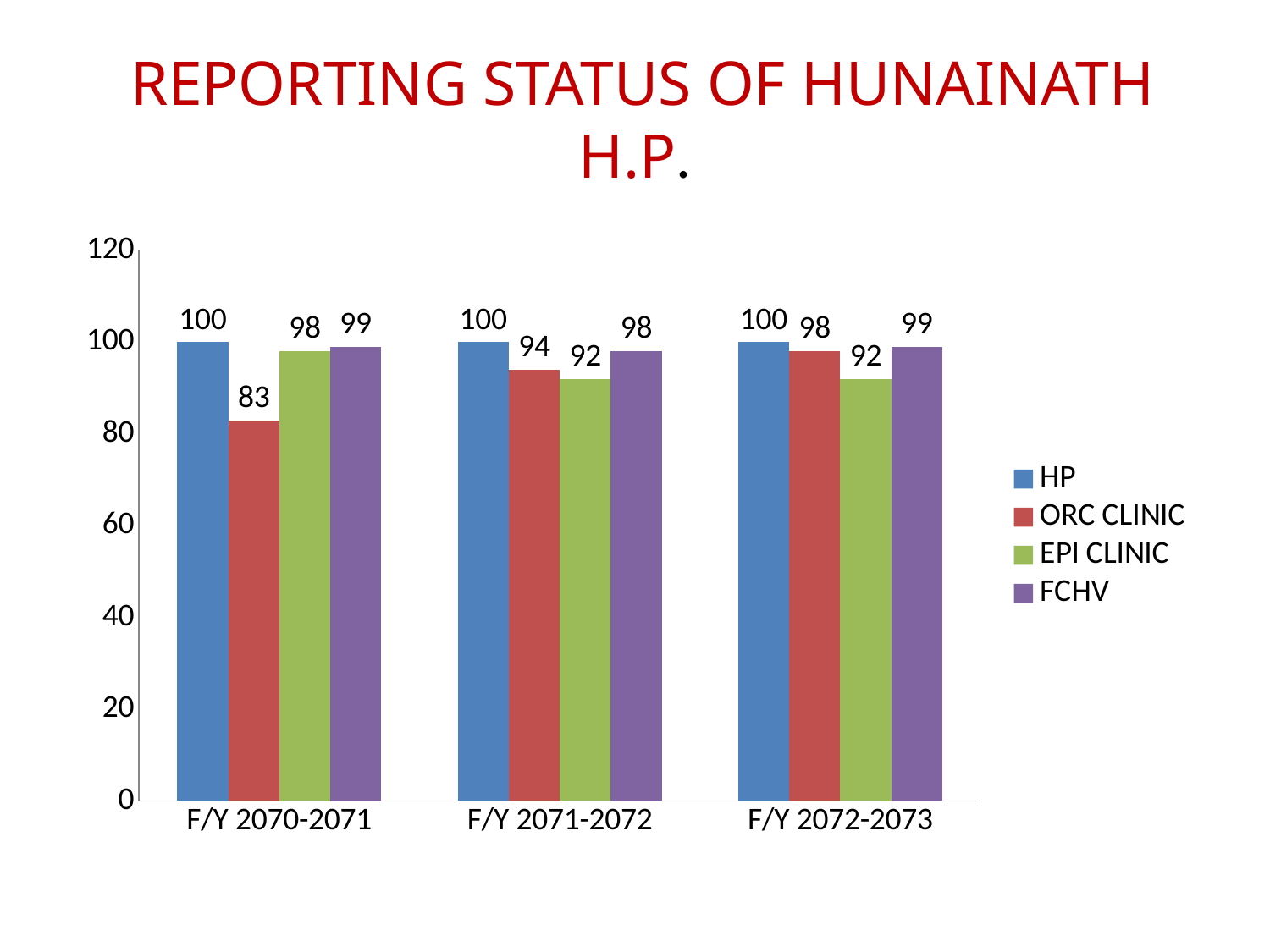
What is the difference between the HP value and the ORC CLINIC value in F/Y 2070-2071? 17 How many series does the legend list? 4 Which series has the lowest value in F/Y 2070-2071? ORC CLINIC How many fiscal year categories are shown on the x axis? 3 What is the value for EPI CLINIC in F/Y 2071-2072? 92 What kind of chart is shown on the slide? Bar chart What is the value for FCHV in F/Y 2072-2073? 99 Which series has the lowest value in F/Y 2072-2073? EPI CLINIC Which is larger in F/Y 2071-2072, the ORC CLINIC value or the EPI CLINIC value? ORC CLINIC What is the value for ORC CLINIC in F/Y 2070-2071? 83 What is the value for HP in F/Y 2071-2072? 100 Does the ORC CLINIC value rise or fall from F/Y 2070-2071 to F/Y 2072-2073? Rise